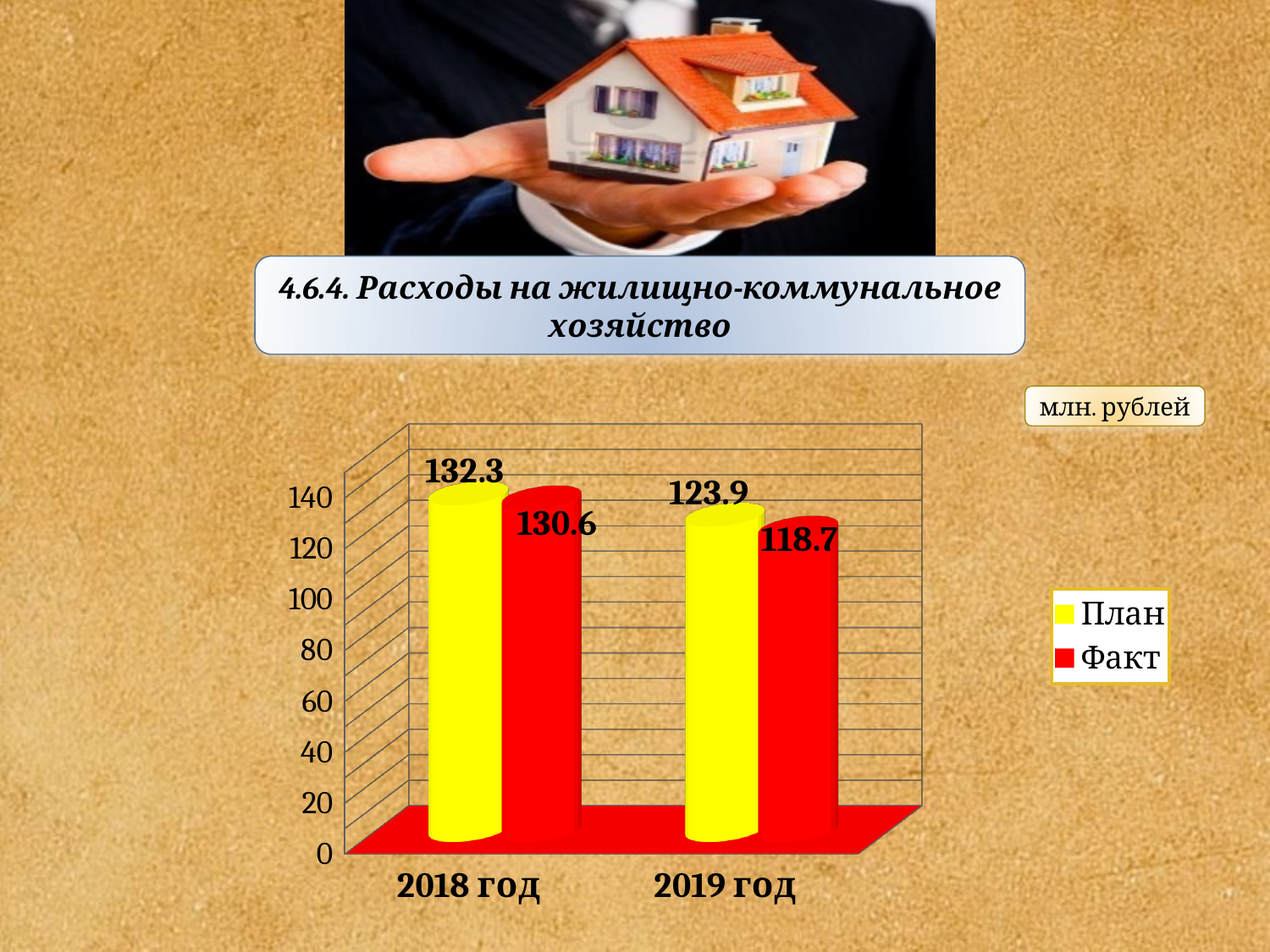
What is the difference between the План values for 2018 год and 2019 год? 8.4 How many series does the legend list? 2 Which year has the lowest Факт value? 2019 год What is the Факт value for 2019 год? 118.7 What kind of chart is shown on the slide? Bar chart What is the План value for 2018 год? 132.3 Which year has the highest План value? 2018 год Which is larger for 2018 год, План or Факт? План What is the План value for 2019 год? 123.9 What is the difference between the План and Факт values for 2019 год? 5.2 What unit is indicated for the chart values? млн. рублей What is the Факт value for 2018 год? 130.6